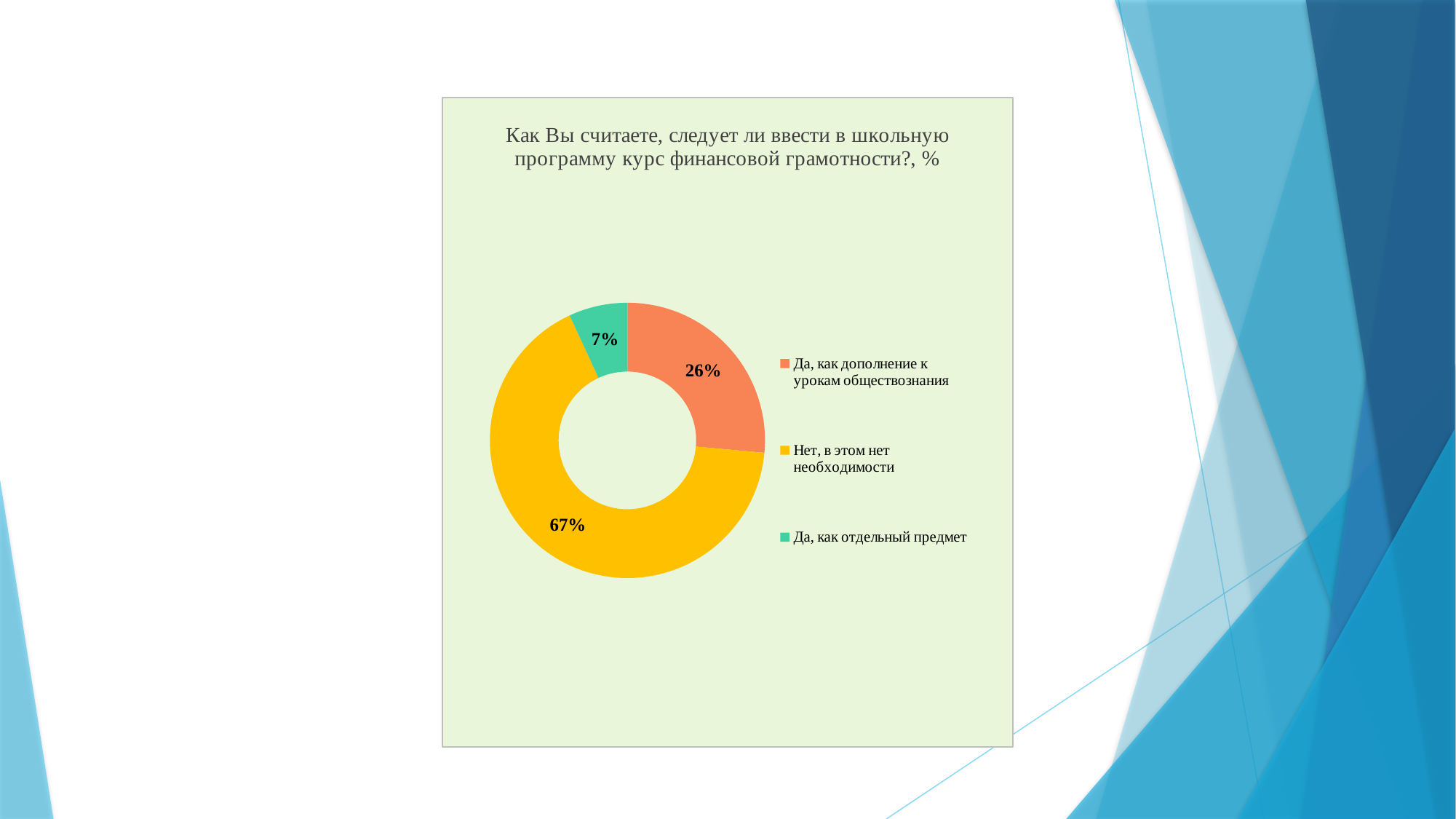
What is the title of the chart? Как Вы считаете, следует ли ввести в школьную программу курс финансовой грамотности?, % What share of respondents answered "Да, как дополнение к урокам обществознания"? 26% What is the difference in percentage points between "Нет, в этом нет необходимости" and "Да, как дополнение к урокам обществознания"? 41 What colour represents "Нет, в этом нет необходимости" in the chart? Yellow What share of respondents answered "Да, как отдельный предмет"? 7% What kind of chart is shown on the slide? Doughnut (pie) chart What is the difference in percentage points between "Да, как дополнение к урокам обществознания" and "Да, как отдельный предмет"? 19 How many answer options are shown in the chart? 3 Which is larger: the share for "Да, как дополнение к урокам обществознания" or for "Да, как отдельный предмет"? Да, как дополнение к урокам обществознания Which answer option has the smallest share? Да, как отдельный предмет Which answer option has the largest share? Нет, в этом нет необходимости What share of respondents answered "Нет, в этом нет необходимости"? 67%